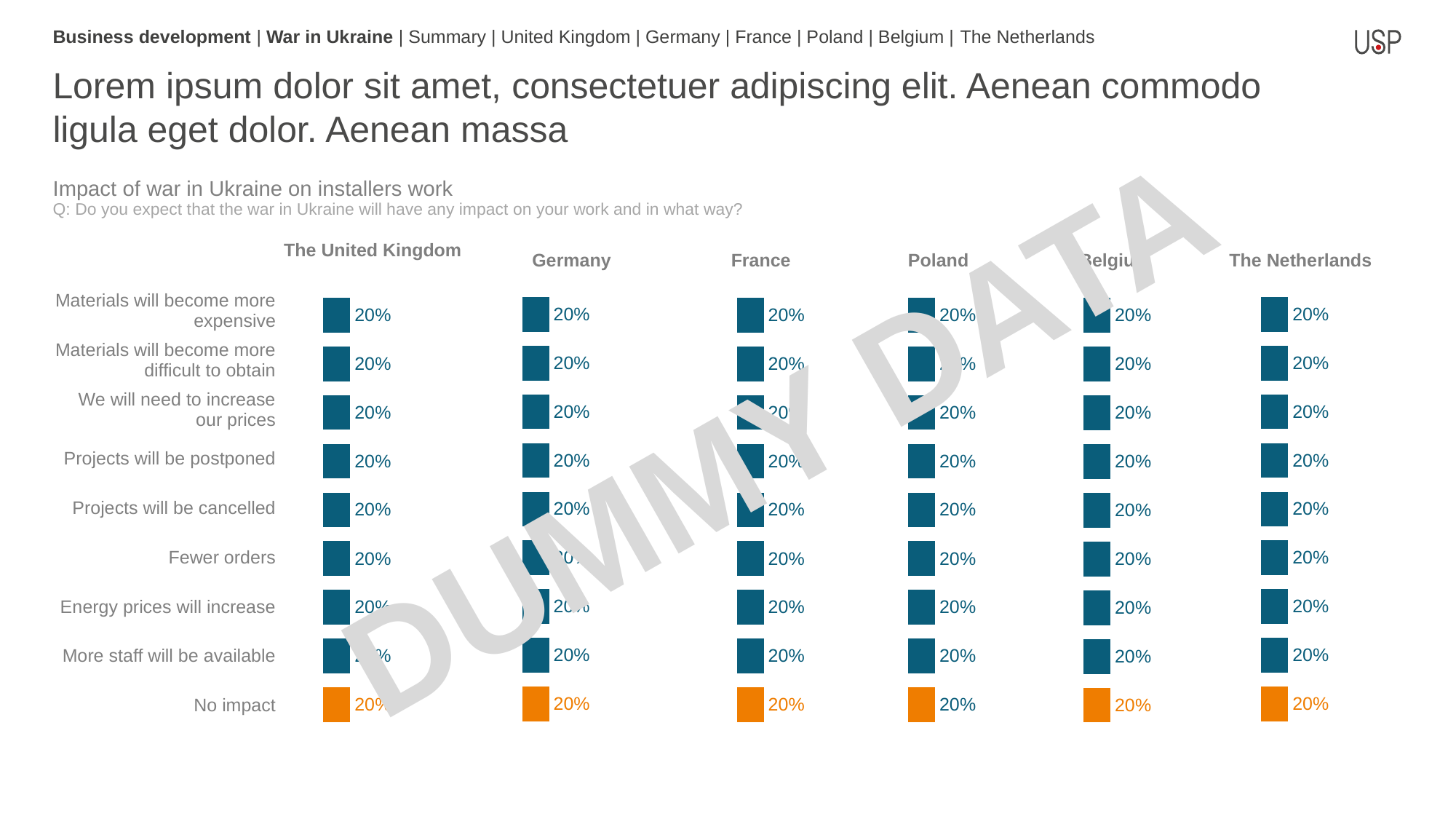
In the United Kingdom chart, what is the value for 'Materials will become more expensive'? 20% In the Netherlands chart, what is the value for 'Energy prices will increase'? 20% Which response category is shown with an orange bar instead of a blue one? No impact What kind of chart is used for each country on the slide? Bar chart In the Germany chart, what is the difference between 'Projects will be cancelled' and 'No impact'? 0% How many countries have their own chart on the slide? 6 In the France chart, what is the value for 'Fewer orders'? 20% In the Netherlands chart, what is the value for 'More staff will be available'? 20% In the Germany chart, what is the value for 'Projects will be postponed'? 20% What is the title of the chart section on the slide? Impact of war in Ukraine on installers work How many response categories are listed down the left side of the charts? 9 In the Poland chart, what is the value for 'No impact'? 20%